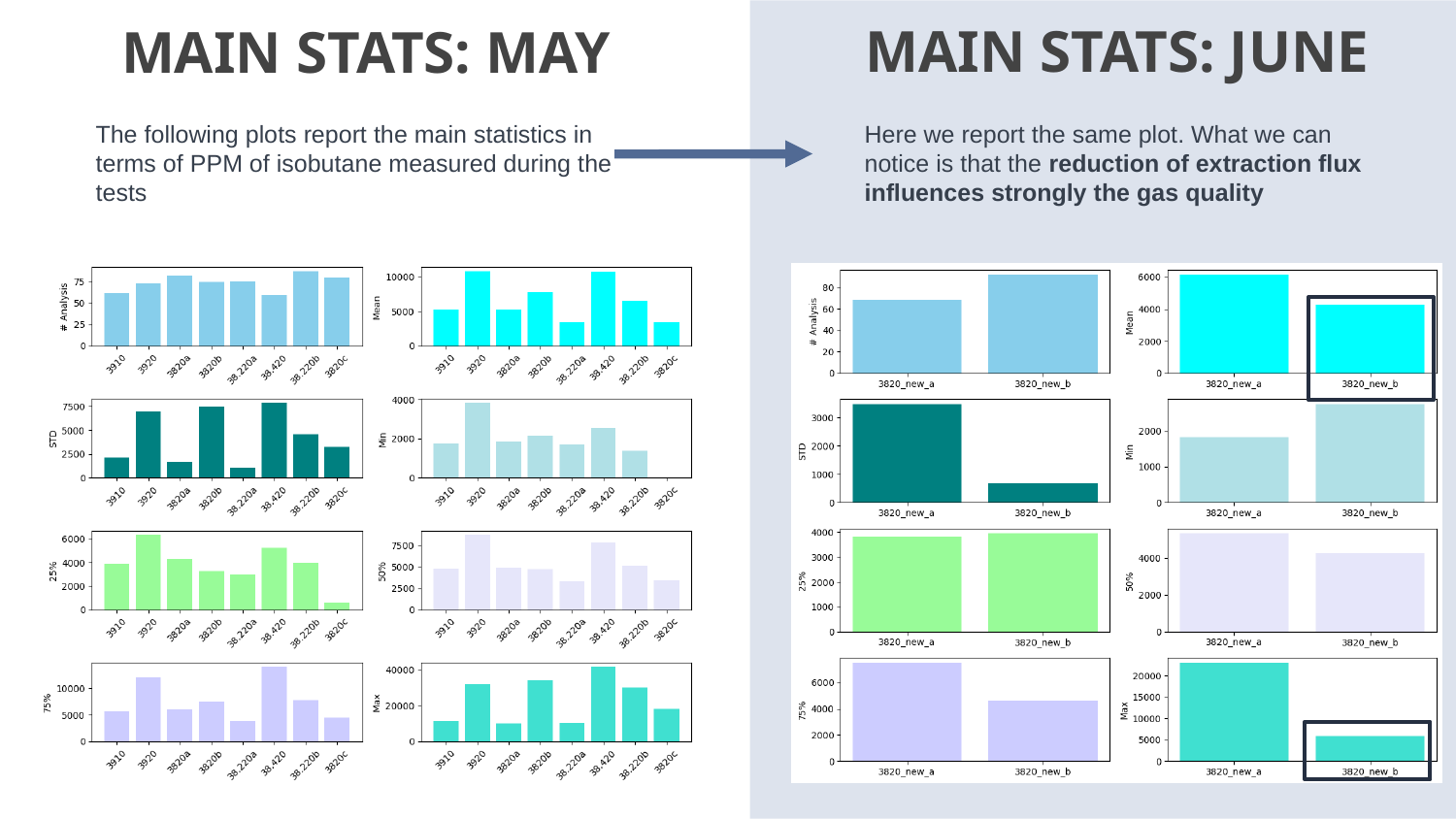
In the 'Max' chart of the MAIN STATS: JUNE panel, which category has the larger value, 3820_new_a or 3820_new_b? 3820_new_a In the 'Mean' chart of the MAIN STATS: JUNE panel, is the value for 3820_new_a greater or less than 5000? greater In the '# Analysis' chart of the MAIN STATS: JUNE panel, which category has the higher value, 3820_new_a or 3820_new_b? 3820_new_b What kind of chart is the 'Max' chart in the MAIN STATS: JUNE panel? bar chart In the 'Max' chart of the MAIN STATS: JUNE panel, is the value for 3820_new_b greater or less than 10000? less In the 'STD' chart of the MAIN STATS: MAY panel, which category has the lowest value? 38.220a In the 'Min' chart of the MAIN STATS: MAY panel, which category has the highest value? 3920 In the 'Max' chart of the MAIN STATS: MAY panel, which category has the highest value? 38.420 How many categories are shown on the x axis of the 'Mean' chart in the MAIN STATS: JUNE panel? 2 In the 'Min' chart of the MAIN STATS: JUNE panel, which category has the higher value, 3820_new_a or 3820_new_b? 3820_new_b How many categories are shown on the x axis of the 'Mean' chart in the MAIN STATS: MAY panel? 8 In the '25%' chart of the MAIN STATS: MAY panel, which category has the highest value? 3920